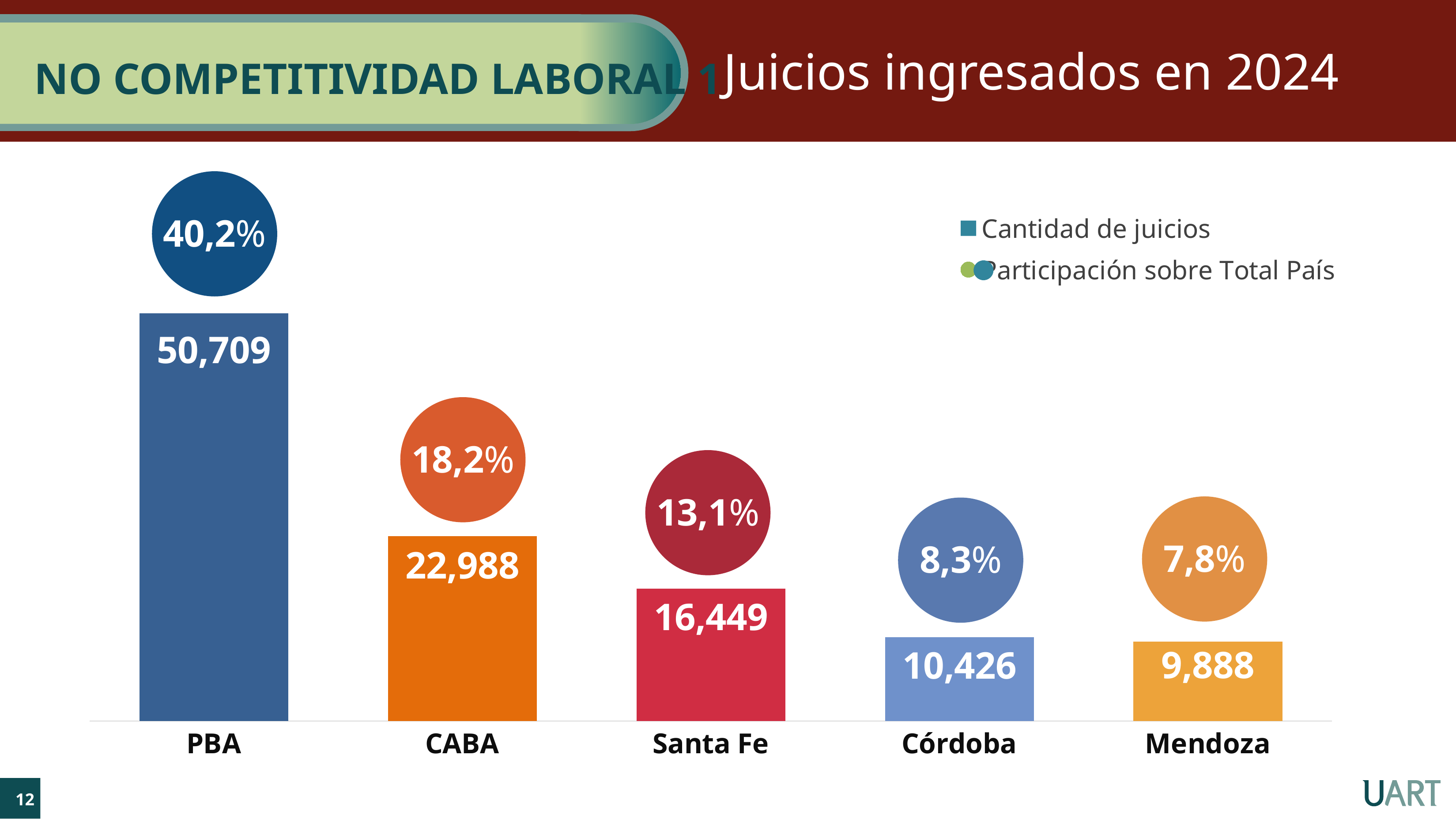
What is the Participación sobre Total País value for Mendoza? 7,8% What kind of chart is shown on the slide? Bar chart Which has a larger Cantidad de juicios, Córdoba or Mendoza? Córdoba What is the Participación sobre Total País value for CABA? 18,2% How many categories are shown on the x axis? 5 How many series does the legend list? 2 What is the Cantidad de juicios value for Santa Fe? 16,449 Which category has the lowest Cantidad de juicios? Mendoza What is the difference in Cantidad de juicios between PBA and CABA? 27,721 What is the Cantidad de juicios value for PBA? 50,709 Do the Cantidad de juicios values rise or fall from PBA to Mendoza along the x axis? Fall Which category has the highest Cantidad de juicios? PBA